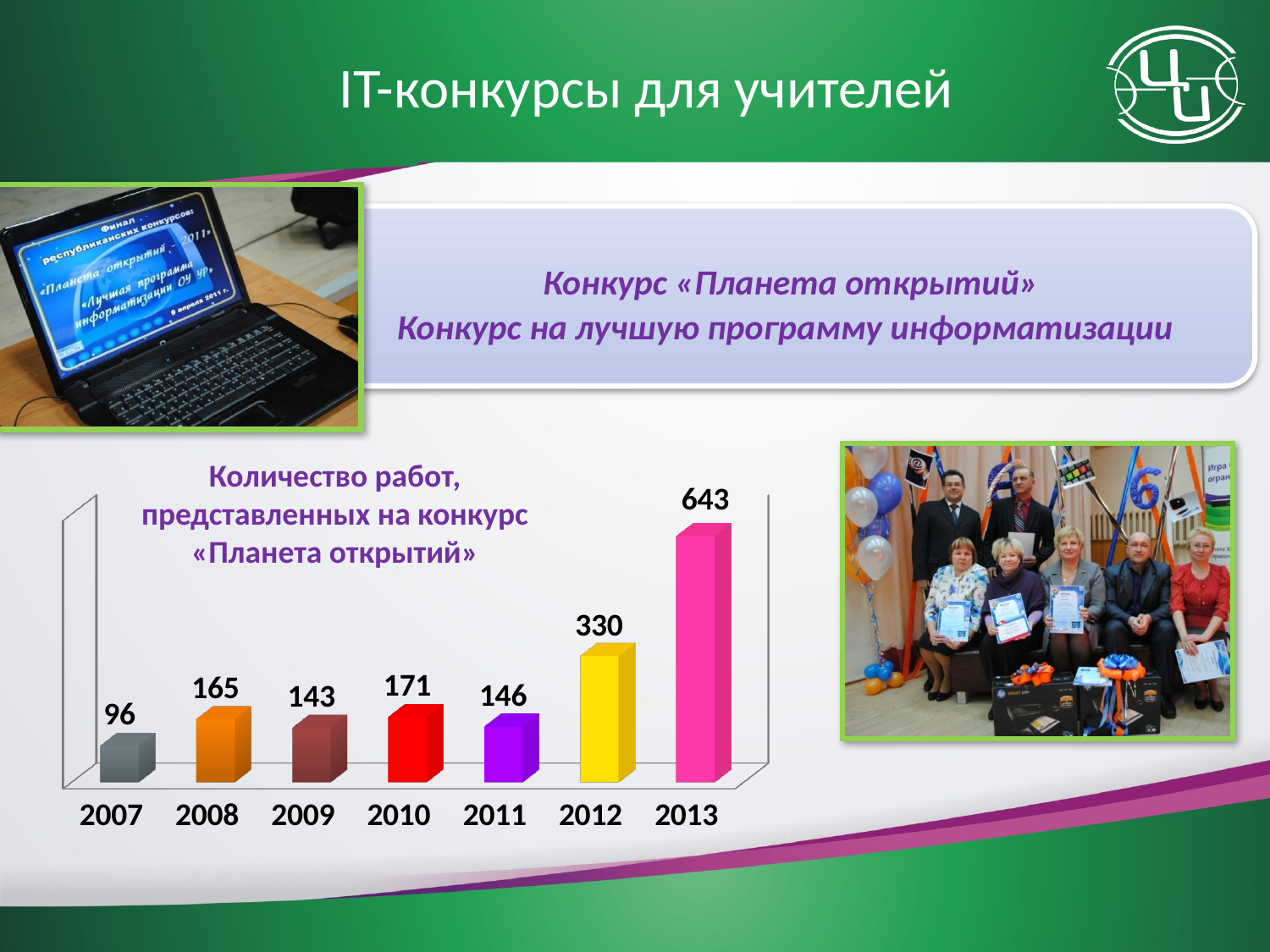
Which is larger, the value for 2010 or the value for 2011? 2010 What kind of chart is this? bar chart What is the value for 2012? 330 How many years are shown on the x axis? 7 What is the value for 2007? 96 Which year has the lowest value? 2007 Do the values rise or fall from 2011 to 2013? rise What is the value for 2010? 171 Which year has the highest value? 2013 What is the title of the chart? Количество работ, представленных на конкурс «Планета открытий» What is the difference between the values for 2013 and 2012? 313 What is the difference between the values for 2008 and 2007? 69